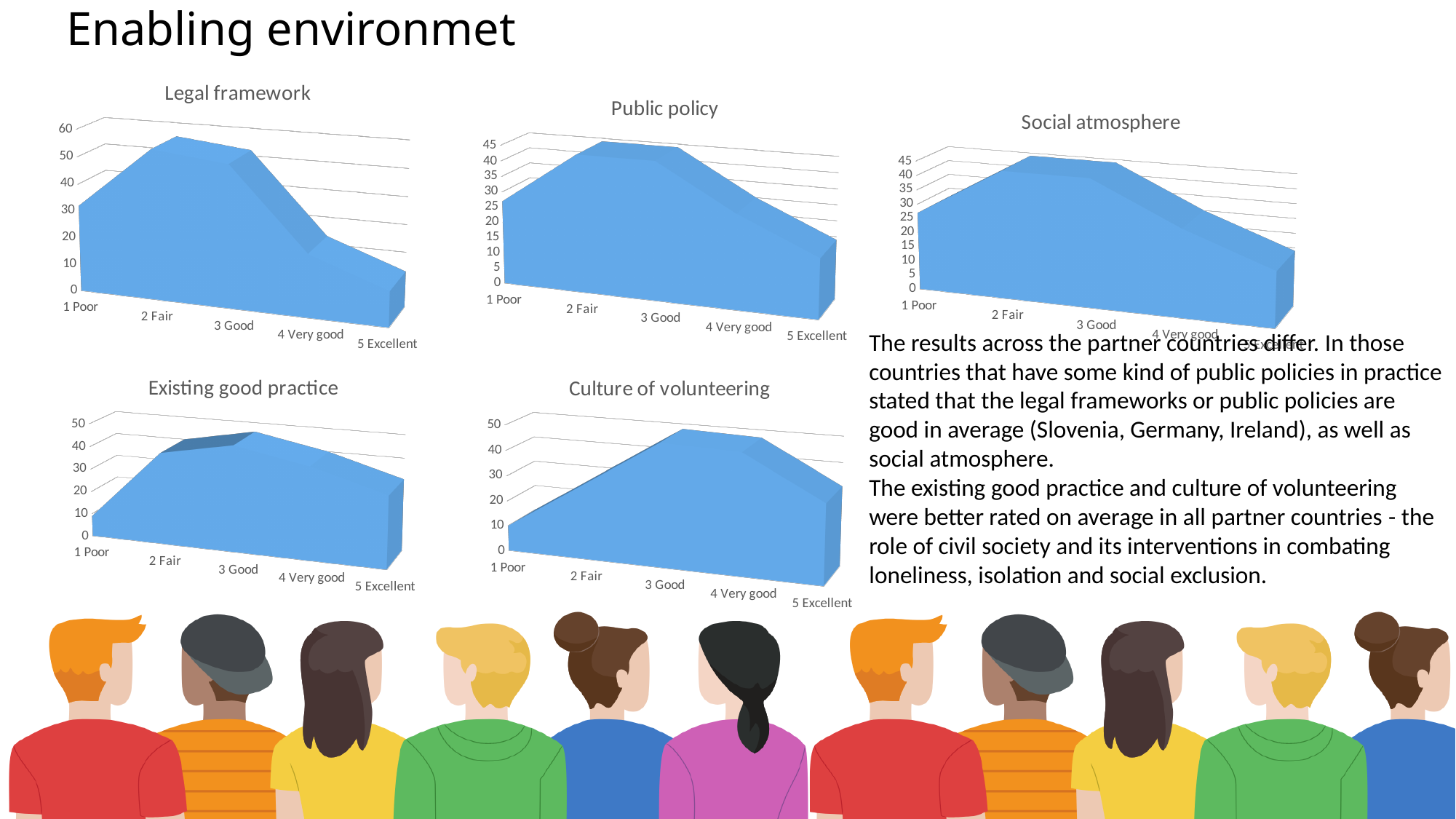
In the 'Legal framework' chart, which category has the highest value? 2 Fair What kind of chart is the 'Legal framework' chart? Area chart In the 'Legal framework' chart, is the value for 1 Poor greater or less than 20? greater In the 'Existing good practice' chart, which category has the highest value? 3 Good In the 'Culture of volunteering' chart, which category has the highest value? 3 Good In the 'Legal framework' chart, which category has the lowest value? 5 Excellent In the 'Existing good practice' chart, which category has the lowest value? 1 Poor In the 'Social atmosphere' chart, is the value for 5 Excellent greater or less than 25? less In the 'Culture of volunteering' chart, is the value for 1 Poor greater or less than 20? less In the 'Public policy' chart, which category has the lowest value? 5 Excellent How many categories are shown on the x axis of the 'Public policy' chart? 5 How many charts are shown on the slide? 5